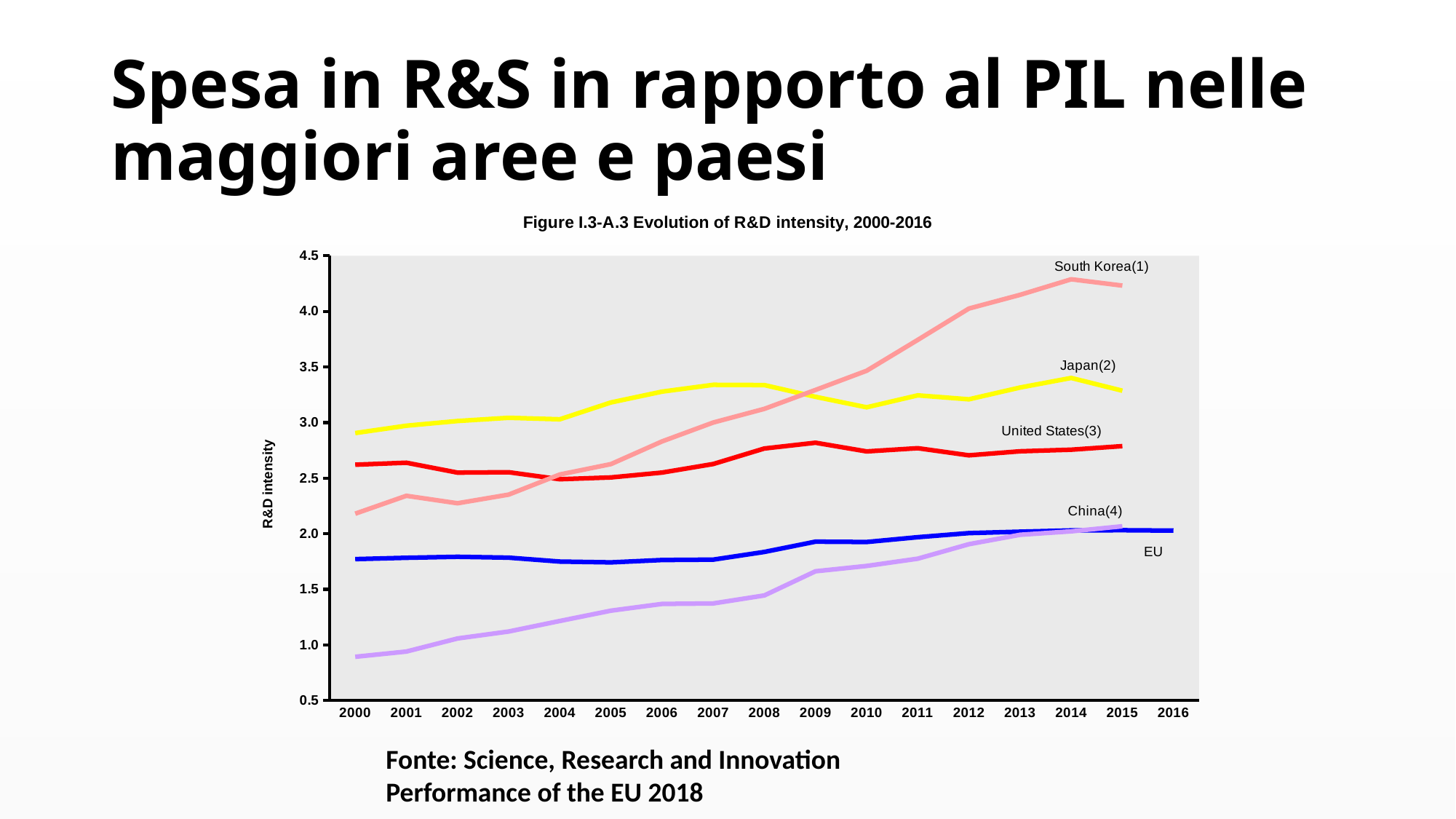
Which series has the highest R&D intensity in 2000? Japan Is the value for the United States in 2009 greater or less than 2.5? greater Which series has the lowest R&D intensity in 2000? China What kind of chart is shown on the slide? Line chart How many series (countries/areas) are plotted on the chart? 5 In 2010, which has the higher R&D intensity, South Korea or Japan? South Korea Does the R&D intensity of China rise or fall from 2000 to 2015? Rises Is the value for South Korea in 2014 greater or less than 4.0? greater Is the value for China in 2000 greater or less than 1.0? less Which series has the highest R&D intensity in 2015? South Korea How many years are shown on the x axis of the chart? 17 What is the title of the chart? Figure I.3-A.3 Evolution of R&D intensity, 2000-2016